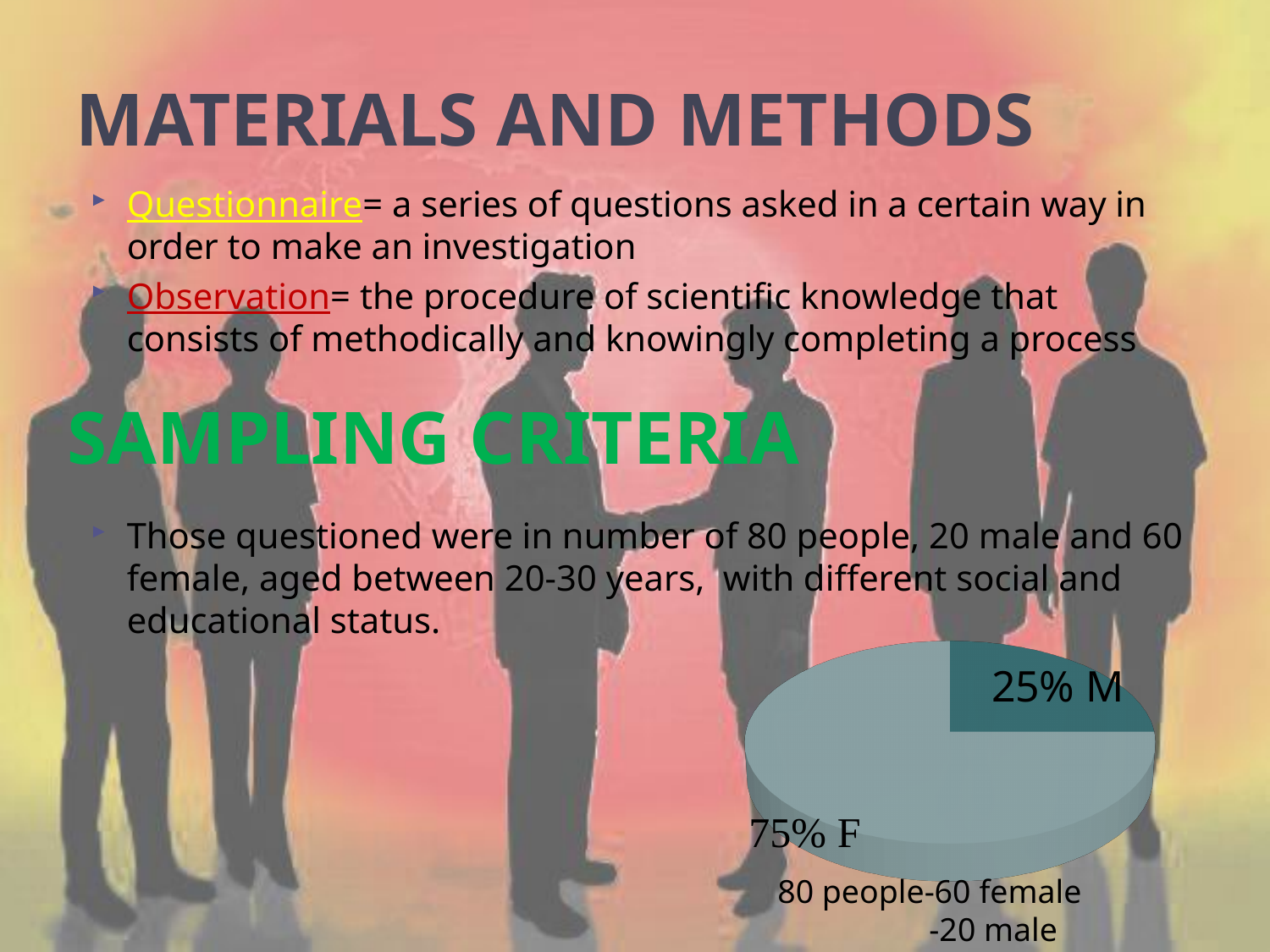
What kind of chart is shown on the slide? pie chart Which is larger in the pie chart, the F slice or the M slice? F What share of the pie chart is labelled F? 75% According to the text below the pie chart, how many of the people surveyed were female? 60 What share of the pie chart is labelled M? 25% What is the difference in percentage points between the F slice and the M slice in the pie chart? 50% Which slice of the pie chart is drawn in the darker teal colour? 25% M Which slice of the pie chart is the smallest? M Which slice of the pie chart is the largest? F According to the text below the pie chart, how many people were surveyed in total? 80 people According to the text below the pie chart, how many of the people surveyed were male? 20 How many slices does the pie chart have? 2